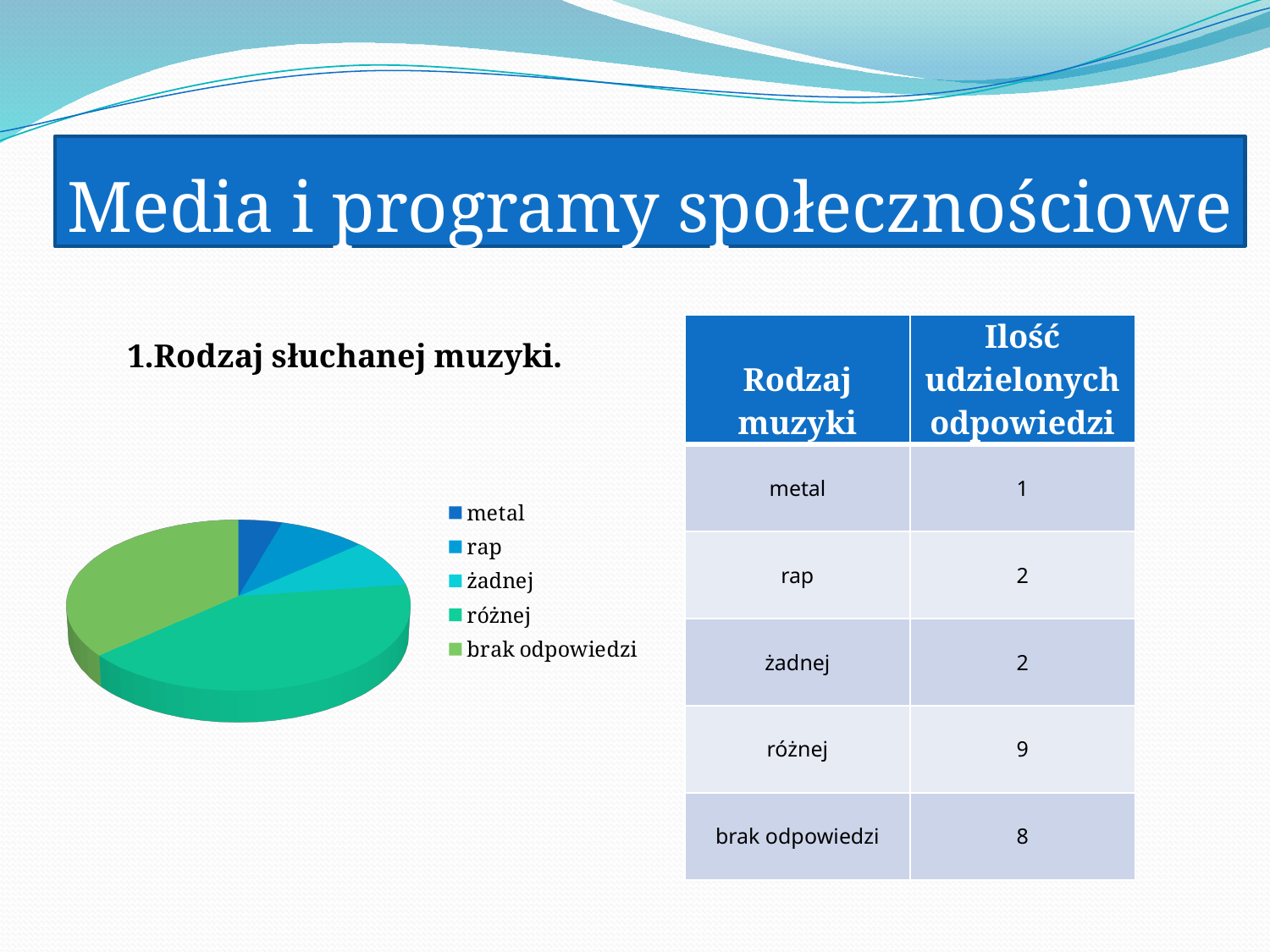
How many categories (slices) does the pie chart have? 5 What is the title of the chart? 1.Rodzaj słuchanej muzyki. What is the difference between the number of responses for "różnej" and "brak odpowiedzi"? 1 Which has more responses, "różnej" or "metal"? różnej Which category has the smallest slice of the pie? metal Which category has the largest slice of the pie? różnej According to the slide, how many responses were given for "rap"? 2 According to the slide, how many responses were given for "metal"? 1 What kind of chart is shown on the slide? pie chart According to the slide, how many responses were given for "brak odpowiedzi"? 8 According to the slide, how many responses were given for "różnej"? 9 How many entries does the chart legend list? 5